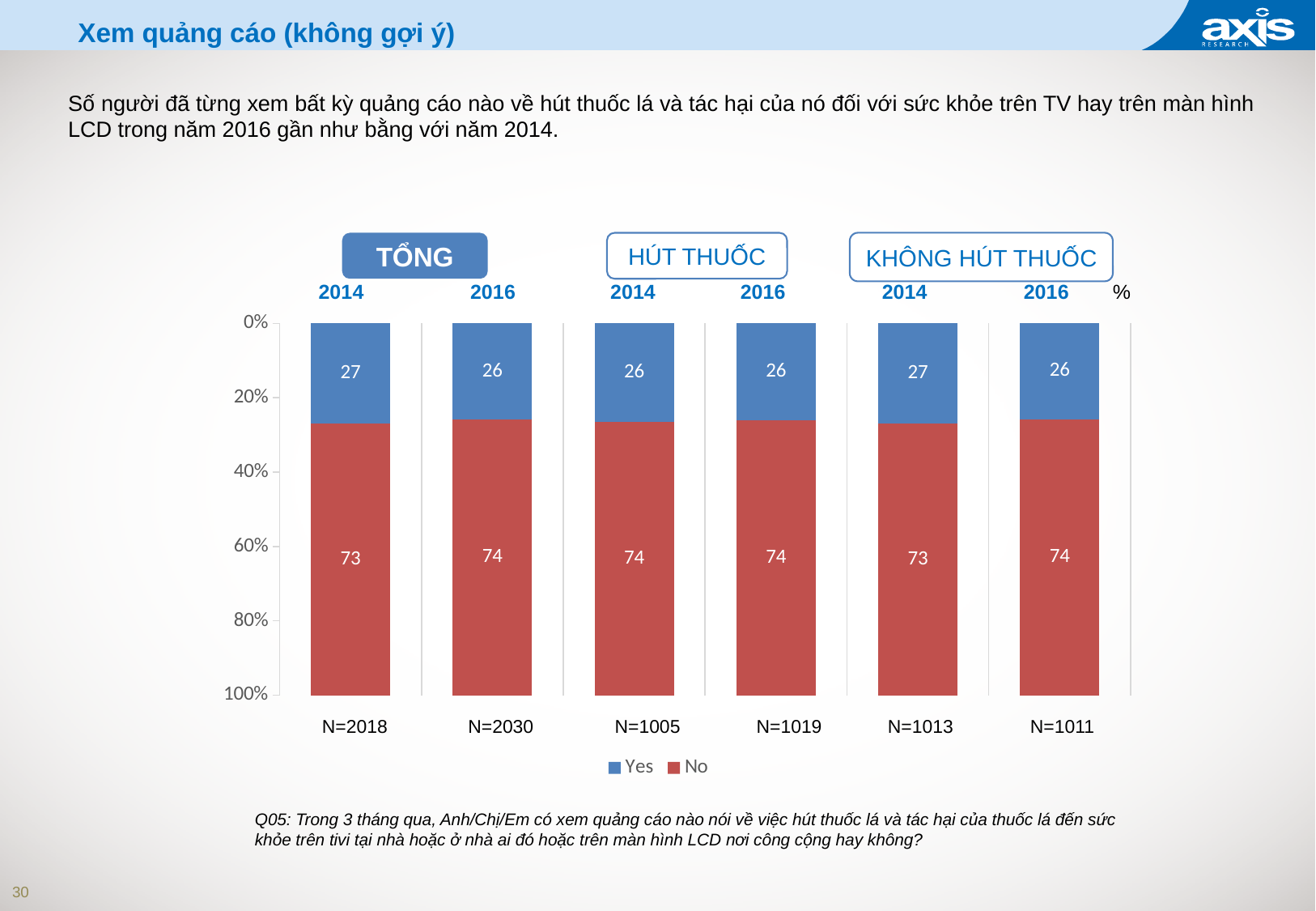
What is the difference between the "No" and "Yes" values for HÚT THUỐC in 2014? 48 What kind of chart is shown on the slide? Stacked bar chart Which is larger for TỔNG 2014, the "Yes" value or the "No" value? No What is the "Yes" value for KHÔNG HÚT THUỐC in 2016? 26 What is the "Yes" value for TỔNG in 2014? 27 How many bars are plotted in the chart? 6 What is the "No" value for HÚT THUỐC in 2016? 74 What is the total of the stacked bar for TỔNG 2016? 100 How many series does the legend list? 2 What is the sample size (N) shown under the HÚT THUỐC 2016 bar? N=1019 Which colour represents the "Yes" series in the chart? Blue What is the "No" value for KHÔNG HÚT THUỐC in 2014? 73